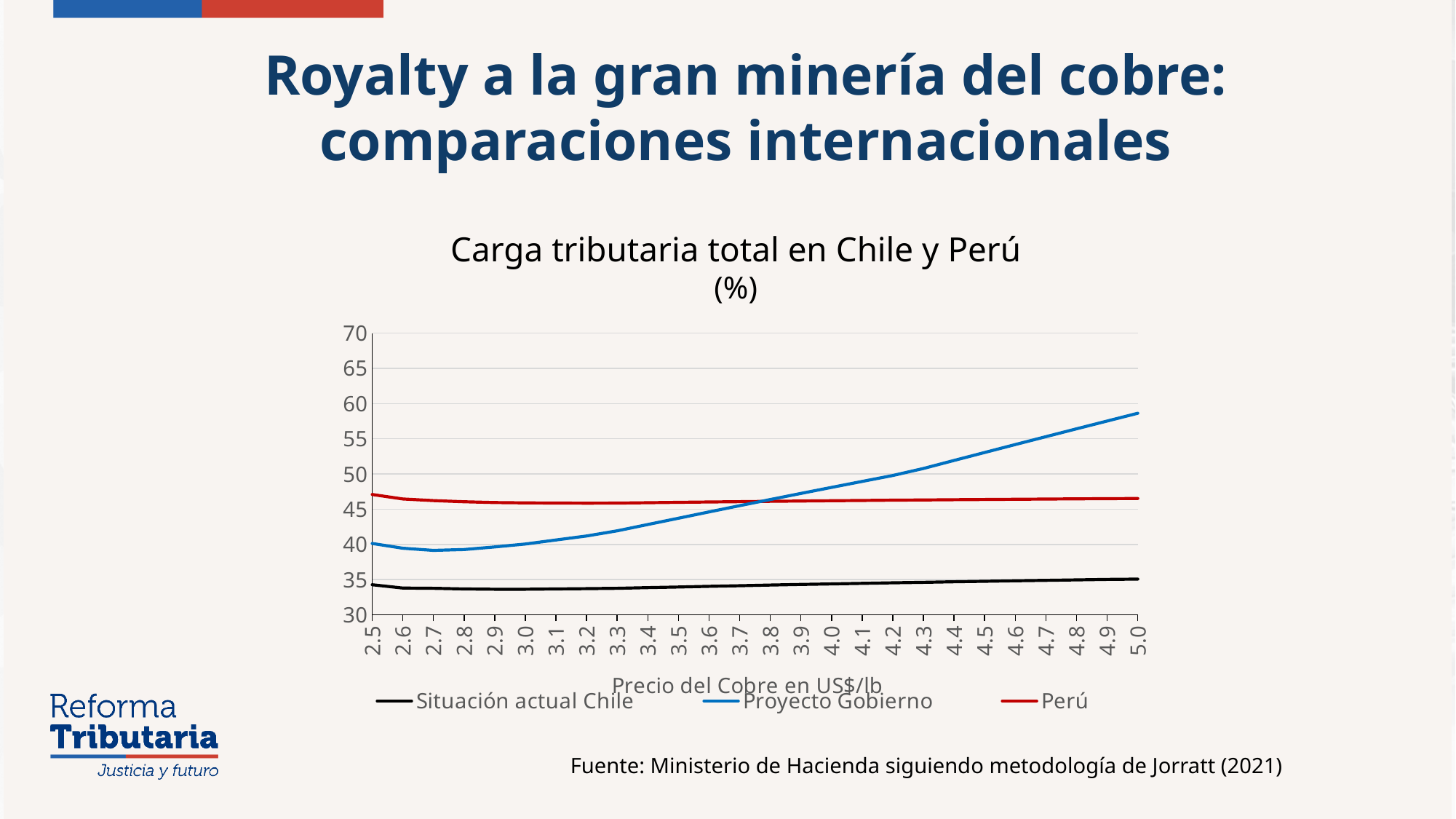
How many series does the legend list? 3 What is the label of the x axis? Precio del Cobre en US$/lb Does the Proyecto Gobierno line rise or fall overall as the copper price increases from 2.5 to 5.0? Rises At a copper price of 4.5, which is larger: the value for Proyecto Gobierno or the value for Perú? Proyecto Gobierno How many copper price points are shown along the x axis? 26 Which series has the highest value at a copper price of 5.0? Proyecto Gobierno Is the value for Proyecto Gobierno at a copper price of 5.0 greater or less than 55? greater Which series has the lowest value at a copper price of 2.5? Situación actual Chile At a copper price of 3.0, which is larger: the value for Perú or the value for Proyecto Gobierno? Perú What kind of chart is shown on the slide? Line chart Is the value for Situación actual Chile at a copper price of 3.0 greater or less than 35? less Is the value for Perú at a copper price of 2.5 greater or less than 45? greater